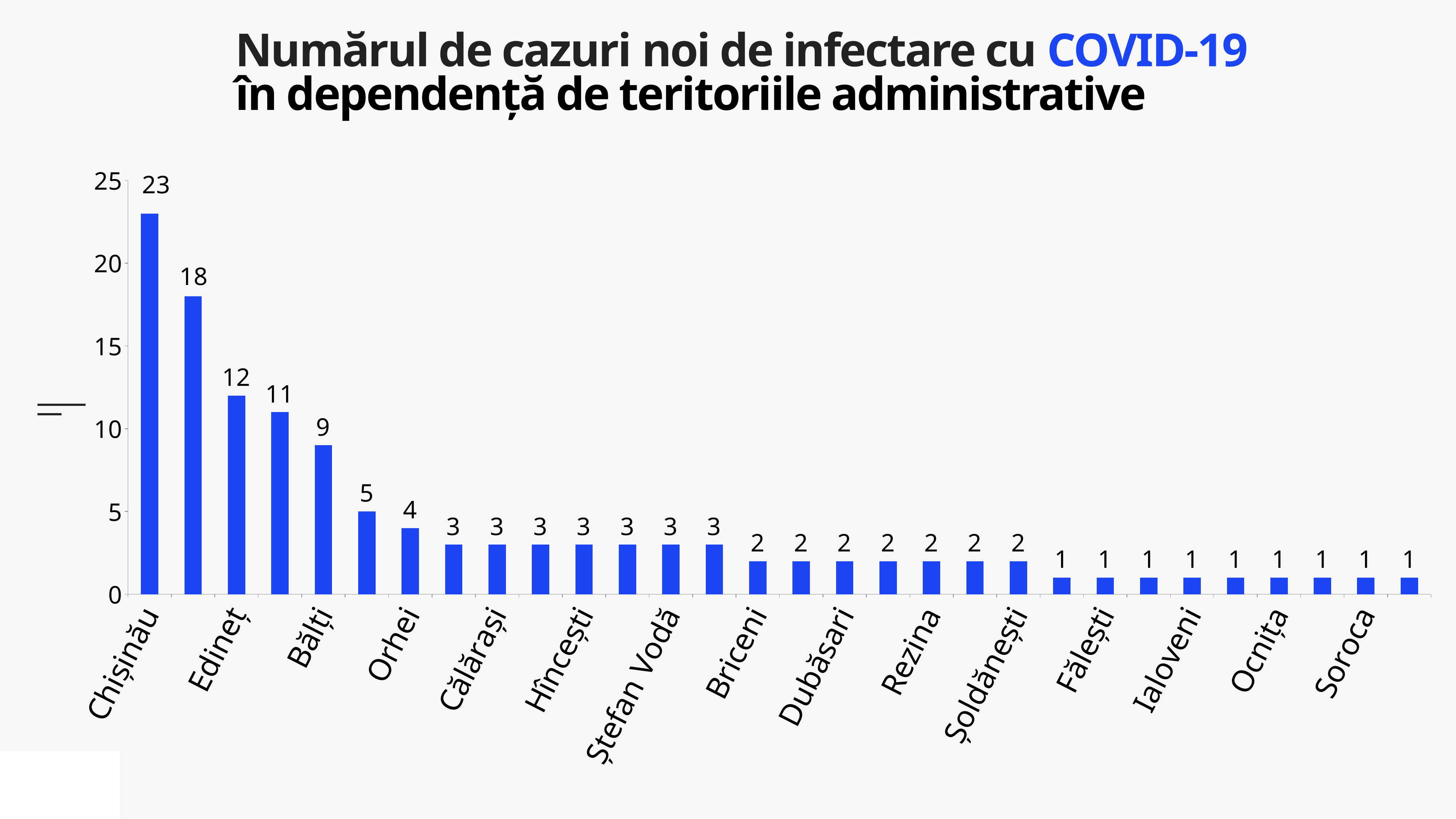
What is the value for Edineț? 12 Which is larger, the value for Bălți or the value for Orhei? Bălți What kind of chart is shown on the slide? bar chart What is the difference between the values for Chișinău and Edineț? 11 What is the value for Chișinău? 23 What is the value for Soroca? 1 Is the value for Chișinău greater or less than 20? greater What is the value for Bălți? 9 What is the value for Orhei? 4 How many bars are plotted in the chart? 30 Do the values rise or fall from left to right along the x axis? fall Which territory has the highest number of new cases? Chișinău